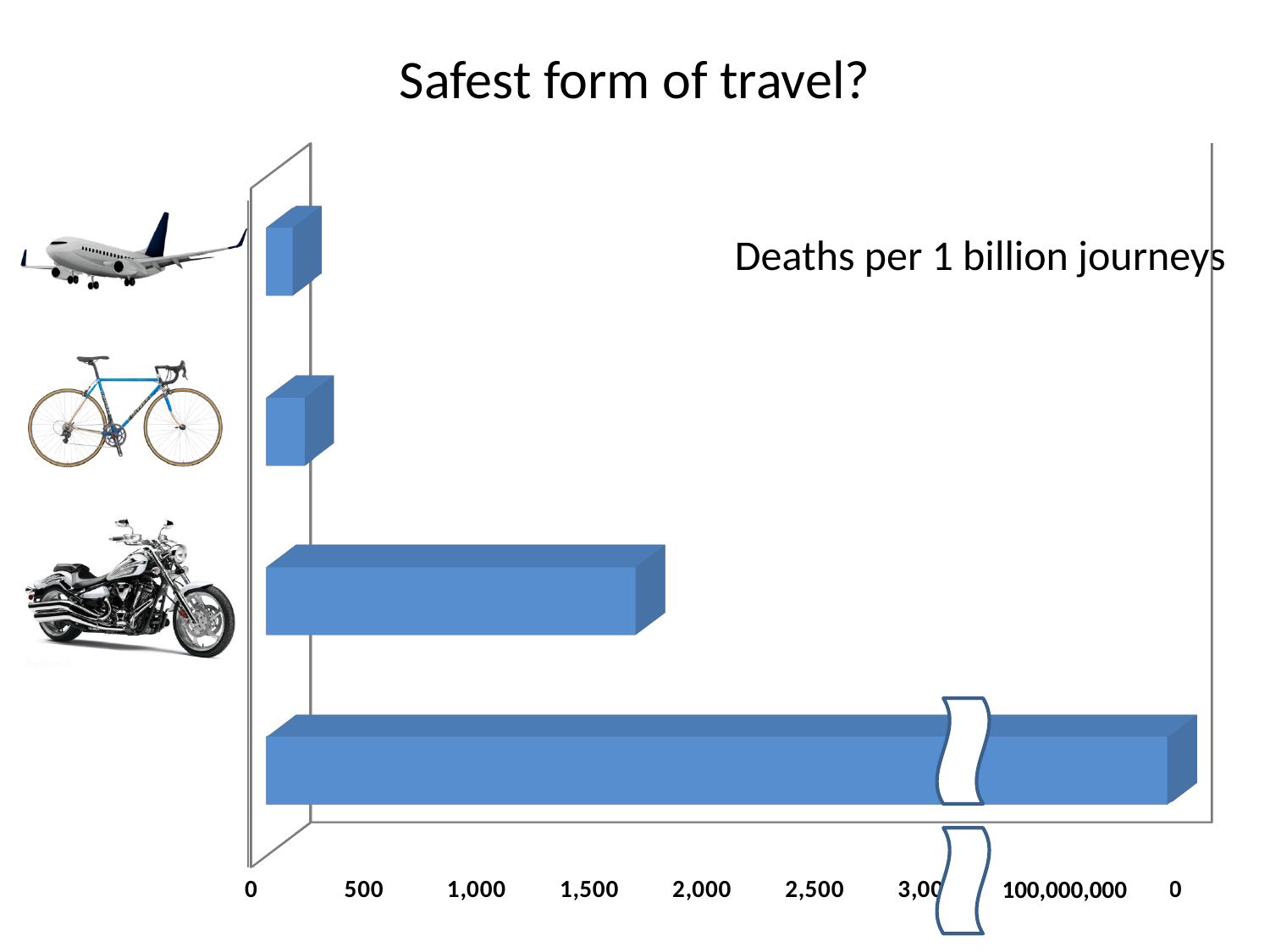
Is the value for the third bar from the top greater or less than 2,000? less Which bar is the longest in the chart? the bottom bar Which is larger, the value for the third bar from the top or the value for the top bar? the third bar from the top What quantity does the chart say it measures, according to the text on the chart? Deaths per 1 billion journeys How many bars are plotted in the chart? 4 What kind of chart is shown on the slide? bar chart Is the value for the top bar greater or less than 500? less What is the title of the slide? Safest form of travel? Is the value for the third bar from the top greater or less than 1,500? greater Which is larger, the value for the bottom bar or the value for the third bar from the top? the bottom bar